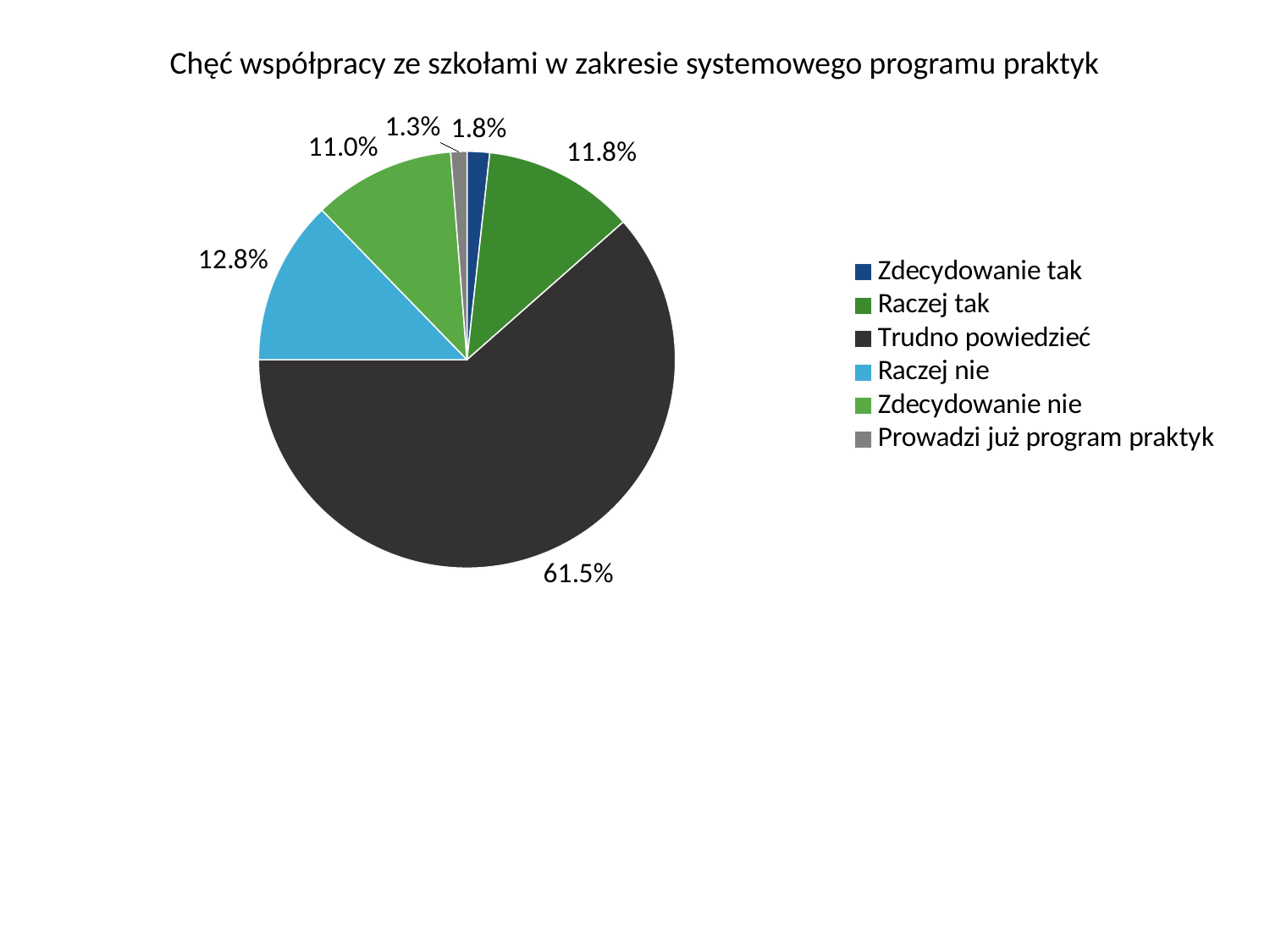
Which is larger, the share for 'Raczej tak' or the share for 'Zdecydowanie nie'? Raczej tak Which category has the largest slice of the pie? Trudno powiedzieć What kind of chart is shown on the slide? pie chart Which category has the smallest slice of the pie? Prowadzi już program praktyk How many categories does the legend list? 6 What share of the pie is 'Trudno powiedzieć'? 61.5% What is the title of the chart? Chęć współpracy ze szkołami w zakresie systemowego programu praktyk What is the difference between the shares for 'Raczej nie' and 'Raczej tak'? 1.0% What share of the pie is 'Prowadzi już program praktyk'? 1.3% What colour is the slice for 'Raczej nie'? light blue What share of the pie is 'Zdecydowanie tak'? 1.8% What share of the pie is 'Raczej nie'? 12.8%